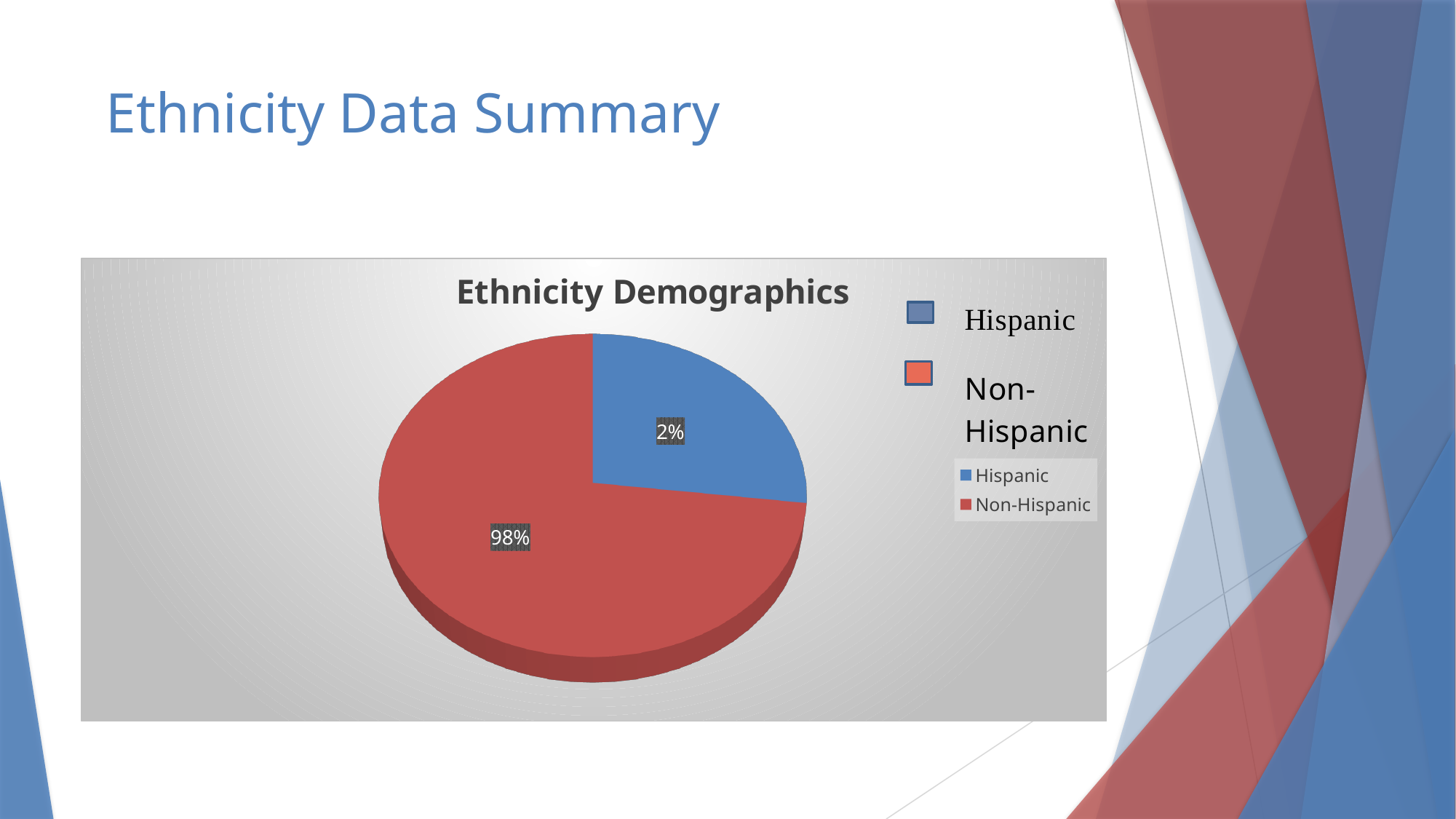
What is the difference in percentage points between the Non-Hispanic and Hispanic labels? 96 How many categories does the pie chart show? 2 Which is larger, the Hispanic share or the Non-Hispanic share? Non-Hispanic What colour is the Non-Hispanic slice? Red Which category has the largest share of the pie? Non-Hispanic What percentage is labelled for the Non-Hispanic slice? 98% Which category has the smallest share of the pie? Hispanic What share of the pie is labelled for Hispanic? 2% How many entries does the chart legend list? 2 What is the title of the chart? Ethnicity Demographics What kind of chart is shown on the slide? Pie chart What percentage is labelled for the Hispanic slice? 2%